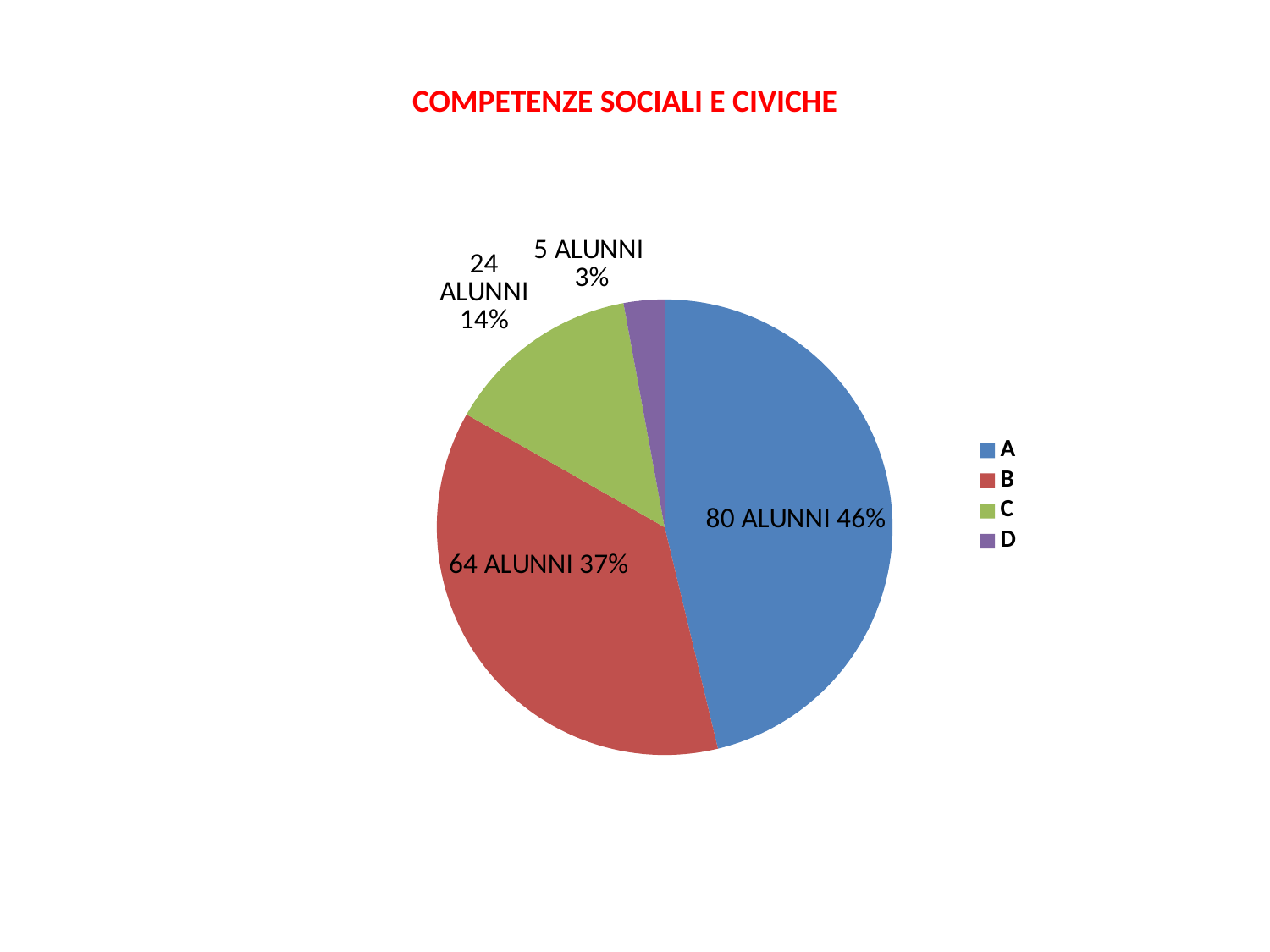
How many entries does the legend list? 4 Which category has the largest slice? A How many alunni are in category C? 24 ALUNNI What is the title of the chart? COMPETENZE SOCIALI E CIVICHE What is the difference in number of alunni between category A and category B? 16 What percentage share does category D have? 3% How many slices does the pie chart have? 4 How many alunni are in category A? 80 ALUNNI Which category has the smallest slice? D What percentage share does category B have? 37% Which category has more alunni, C or D? C What kind of chart is shown on the slide? pie chart